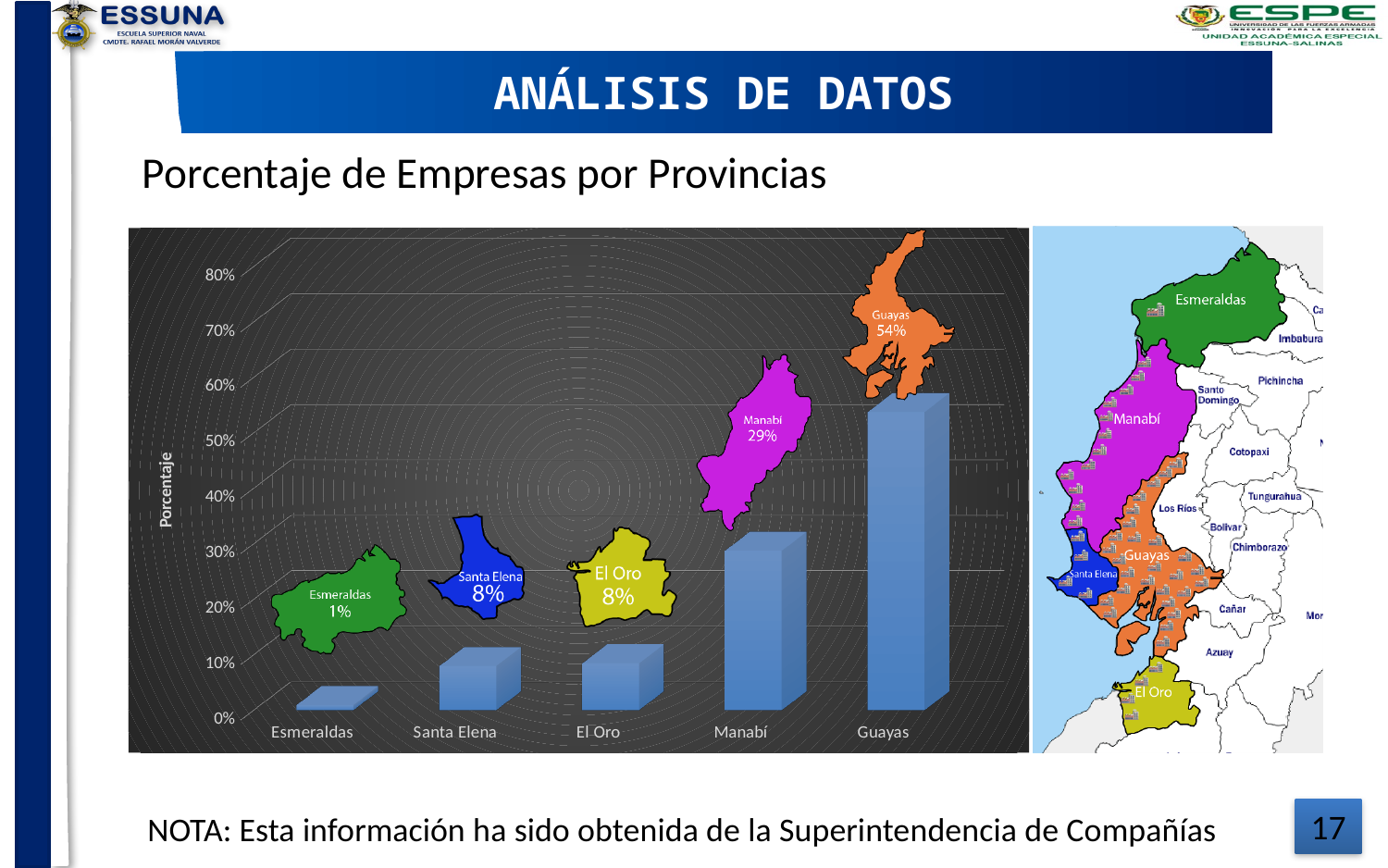
What is the difference between the percentages for Guayas and Manabí? 25% What percentage is shown for Santa Elena? 8% What percentage is shown for Guayas? 54% Is the value for Guayas greater or less than 50%? greater Which province has the lowest percentage of companies? Esmeraldas Which province has the highest percentage of companies? Guayas How many provinces are shown on the x axis of the chart? 5 What is the title of the vertical axis of the chart? Porcentaje What percentage is shown for Manabí? 29% What percentage is shown for Esmeraldas? 1% What kind of chart is used to show the percentage of companies by province? Bar chart Which has a larger percentage, Manabí or El Oro? Manabí